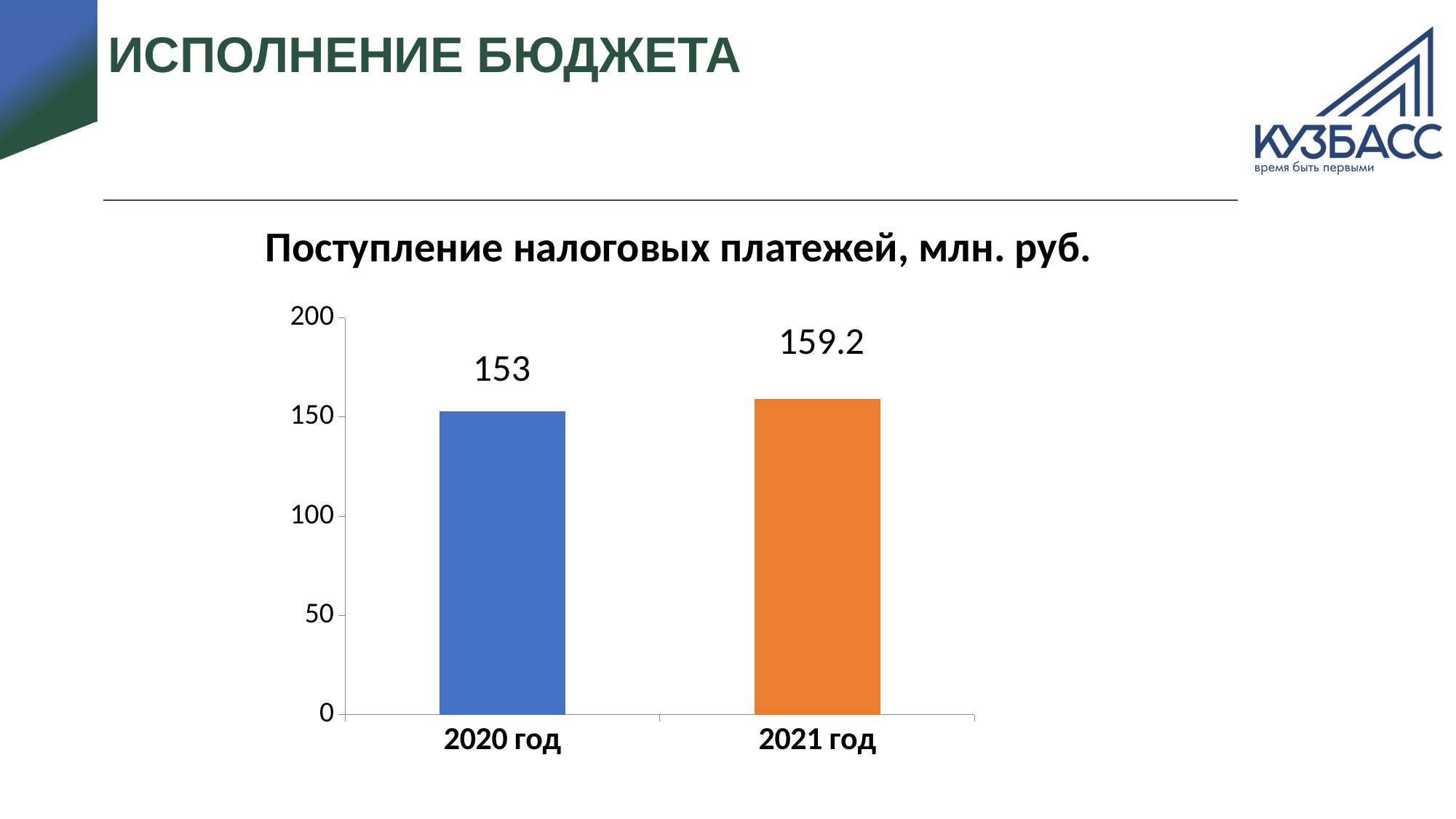
What is the value for 2020 год? 153 What kind of chart is shown on the slide? bar chart Which year has the lowest value? 2020 год Which year has the highest value? 2021 год Which is larger, the value for 2020 год or 2021 год? 2021 год How many categories are shown on the chart? 2 What is the difference between the values for 2021 год and 2020 год? 6.2 What is the title of the chart? Поступление налоговых платежей, млн. руб. Is the value for 2020 год greater or less than 100? greater What is the value for 2021 год? 159.2 Do the values rise or fall from 2020 год to 2021 год? rise Is the value for 2021 год greater or less than 200? less